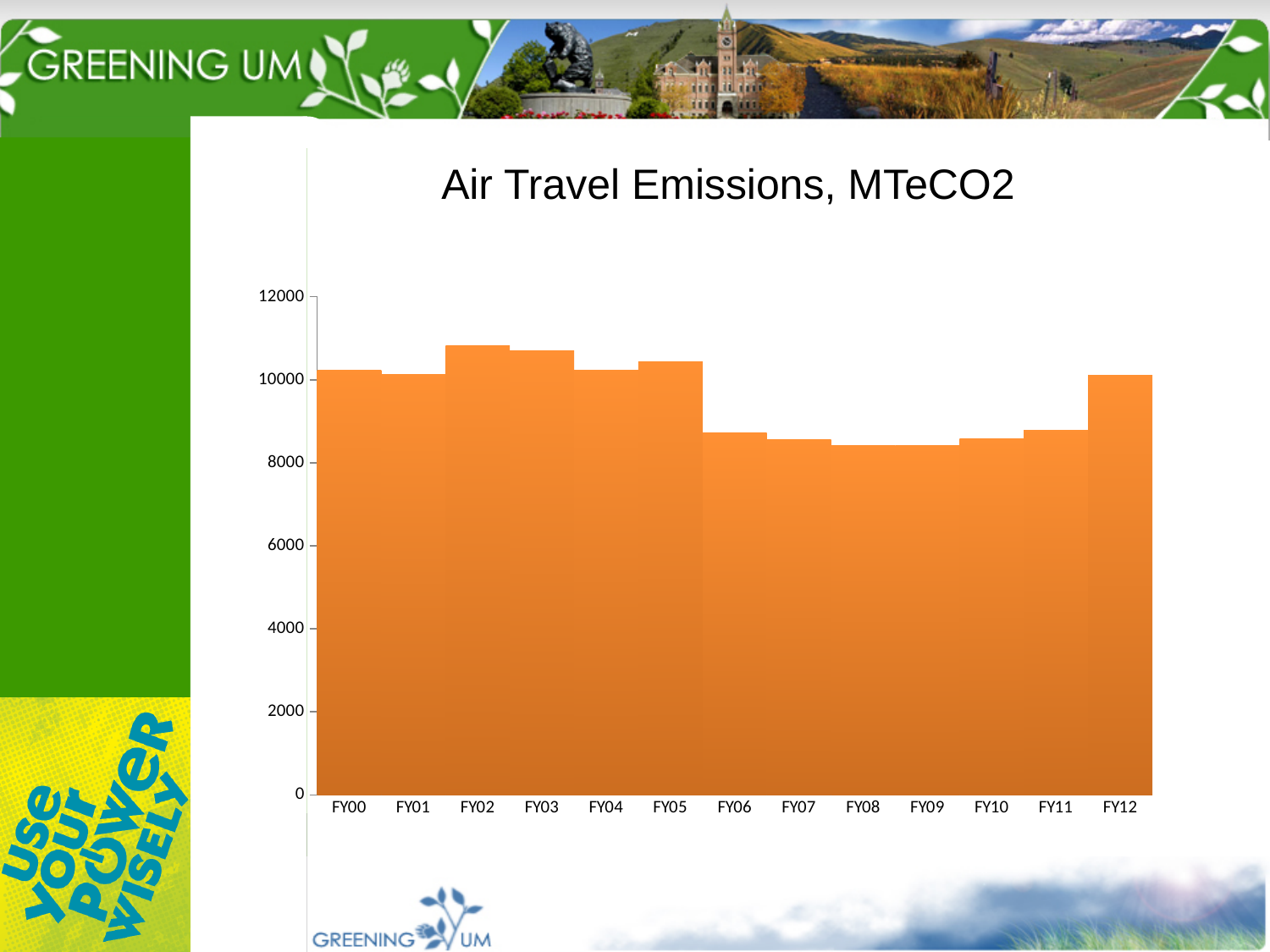
What is the title of the chart? Air Travel Emissions, MTeCO2 Is the value for FY00 greater or less than 10000? greater Which is larger, the value for FY05 or the value for FY06? FY05 Which is larger, the value for FY12 or the value for FY09? FY12 Does the value rise or fall from FY09 to FY12? rise Is the value for FY08 greater or less than 8000? greater Is the value for FY02 greater or less than 10000? greater Does the value rise or fall from FY05 to FY06? fall How many fiscal years are plotted on the x axis? 13 What kind of chart is shown on the slide? bar chart